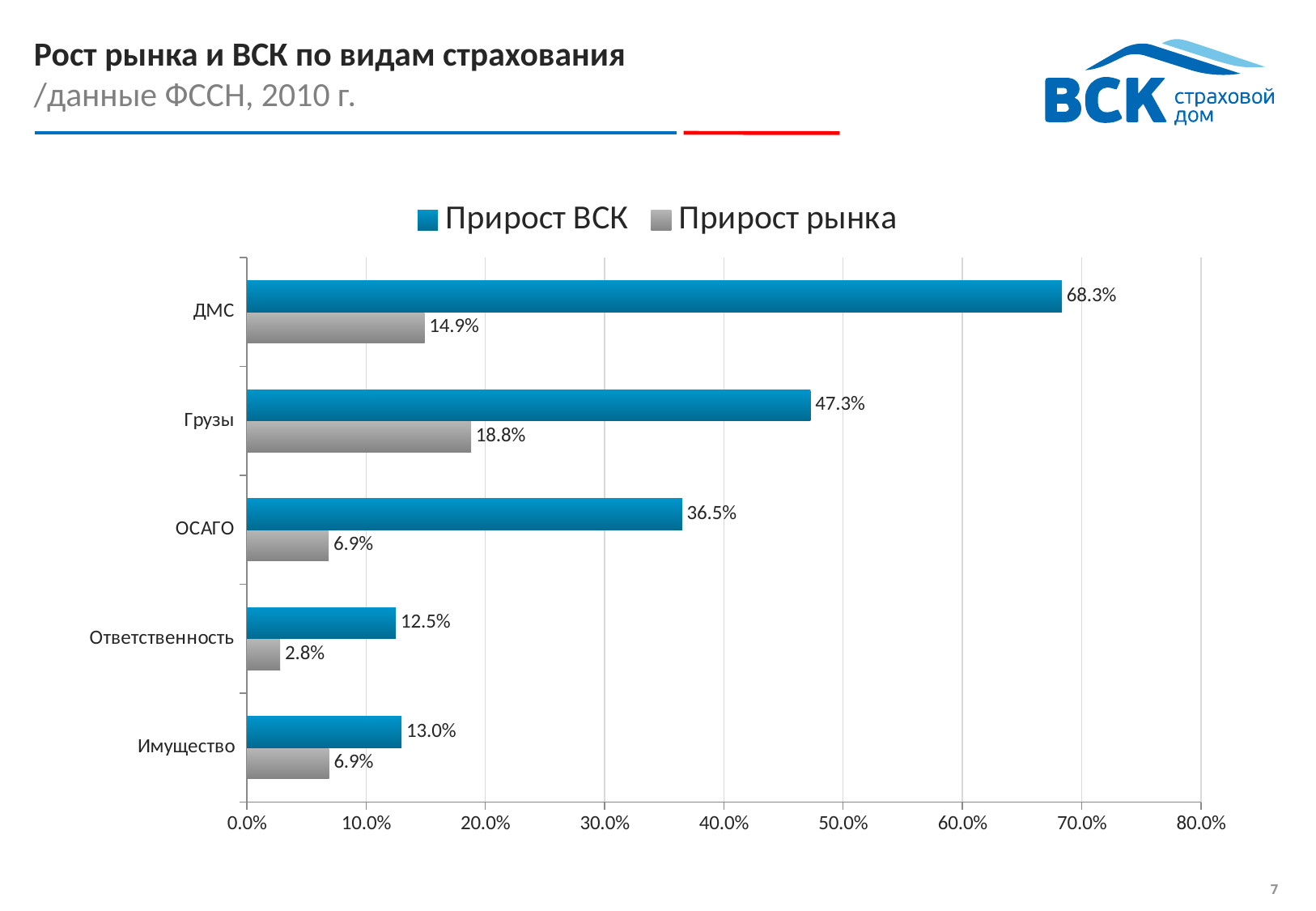
Which category has the highest Прирост ВСК value? ДМС What kind of chart is shown on the slide? bar chart Is the Прирост ВСК value for Грузы greater or less than 40.0%? greater What is the difference between Прирост ВСК and Прирост рынка for ОСАГО? 29.6% Which category has the lowest Прирост рынка value? Ответственность What is the value of Прирост рынка for Грузы? 18.8% Which is larger for Имущество: Прирост ВСК or Прирост рынка? Прирост ВСК What colour are the Прирост рынка bars? grey What is the value of Прирост ВСК for ДМС? 68.3% How many categories are shown on the chart? 5 What is the value of Прирост ВСК for Ответственность? 12.5% How many series does the legend list? 2